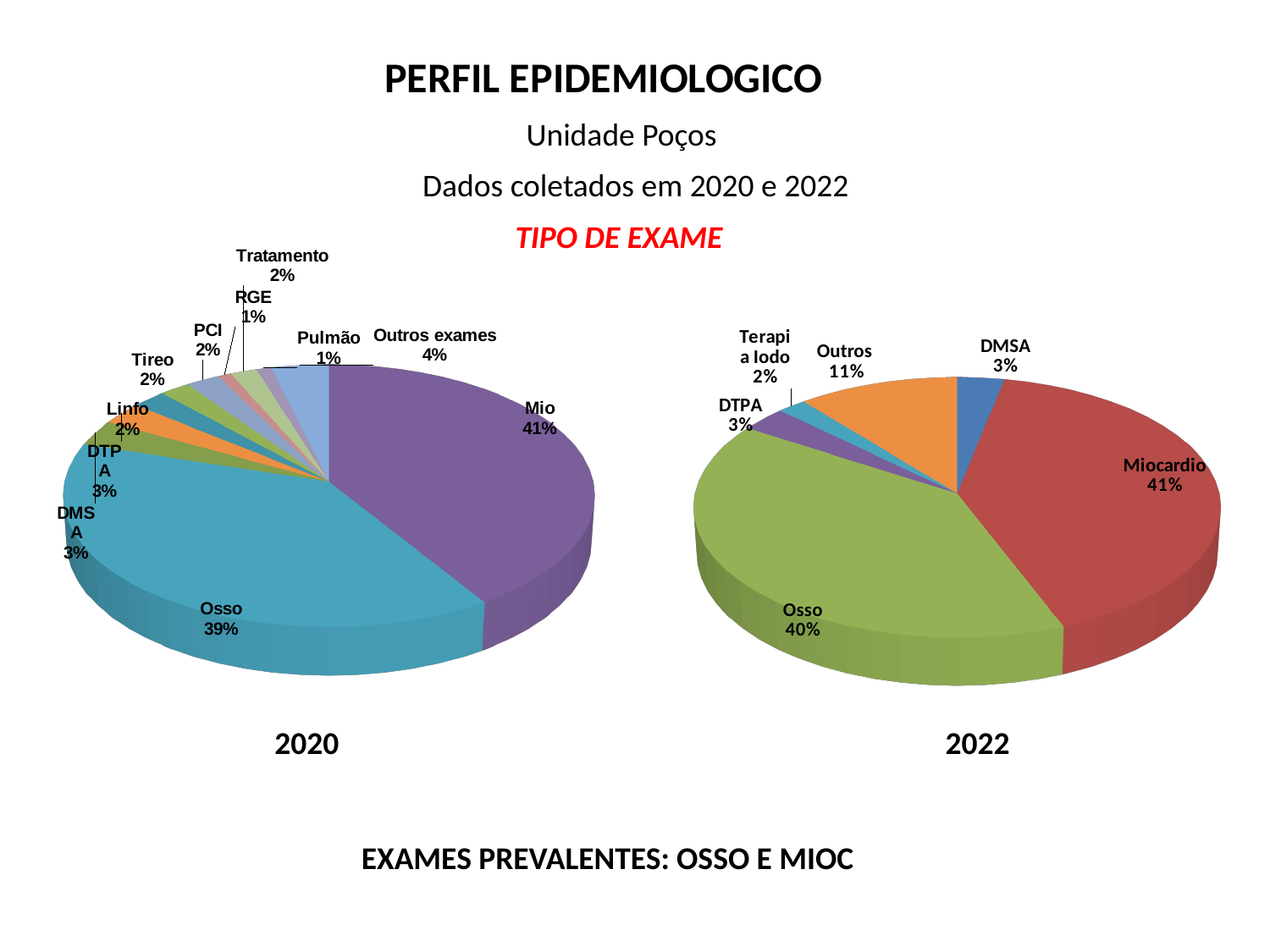
In the 2020 pie chart, which category has the largest share? Mio In the 2022 pie chart, what share does DTPA have? 3% What kind of chart is used for the 2020 data? Pie chart In the 2022 pie chart, which category has the smallest share? Terapia Iodo In the 2022 pie chart, what share does Outros have? 11% How many categories are shown in the 2020 pie chart? 11 What is the red subtitle shown above the two pie charts? TIPO DE EXAME How many categories are shown in the 2022 pie chart? 6 In the 2020 pie chart, what share does Pulmão have? 1% In the 2022 pie chart, what is the difference between the Miocardio share and the Osso share? 1% In the 2020 pie chart, which is larger, the share for Outros exames or the share for DMSA? Outros exames In the 2020 pie chart, what share does Osso have? 39%